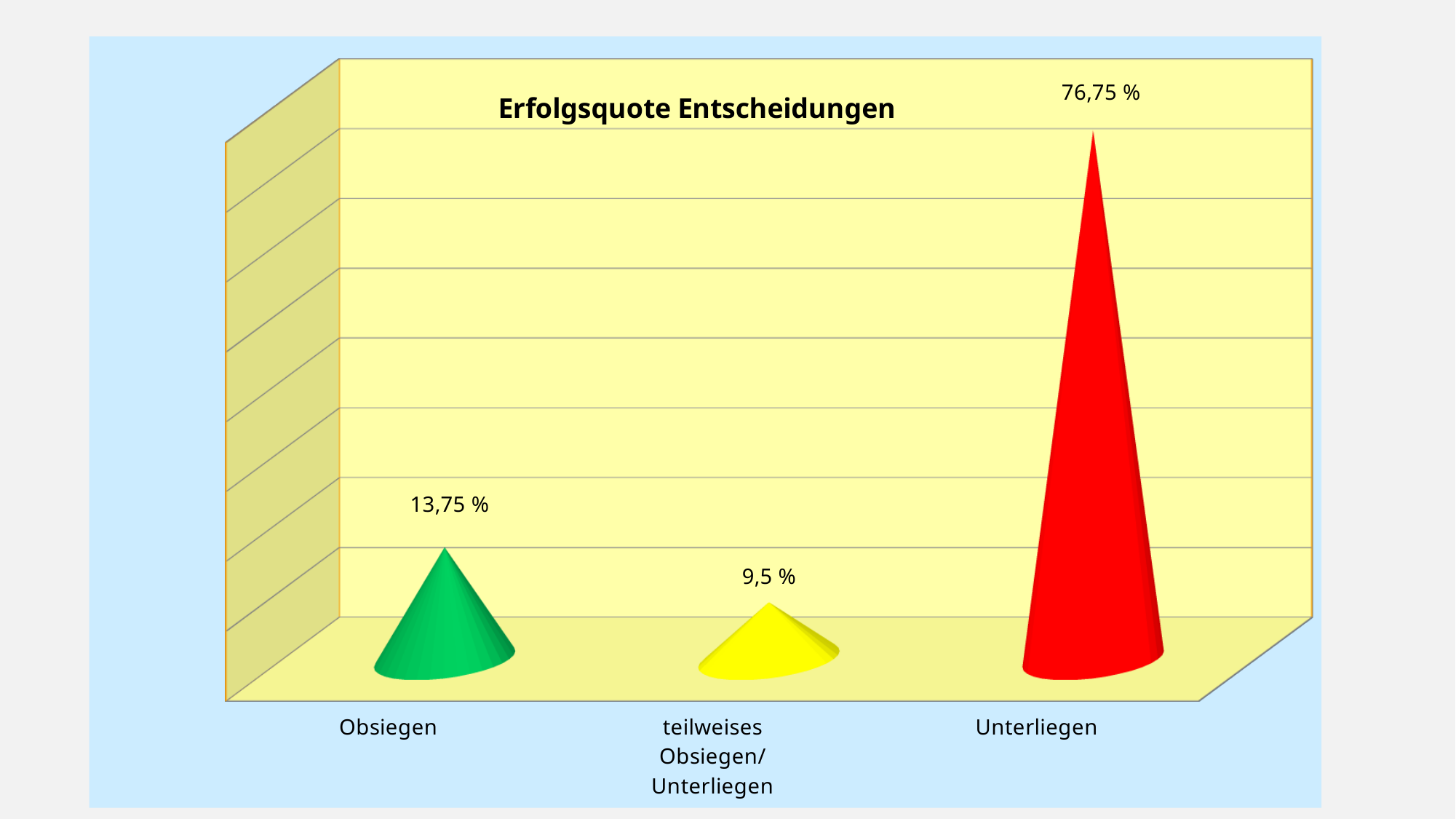
Which category has the highest value? Unterliegen What is the value for teilweises Obsiegen/Unterliegen? 9,5 % What is the value for Unterliegen? 76,75 % What is the title of the chart? Erfolgsquote Entscheidungen How many categories are shown in the chart? 3 What kind of chart is shown on the slide? bar chart What colour is the bar for Unterliegen? red Which category has the lowest value? teilweises Obsiegen/Unterliegen What is the difference between the values for Unterliegen and Obsiegen? 63 % What is the value for Obsiegen? 13,75 % What is the difference between the values for Obsiegen and teilweises Obsiegen/Unterliegen? 4,25 % Which is larger, the value for Obsiegen or the value for teilweises Obsiegen/Unterliegen? Obsiegen